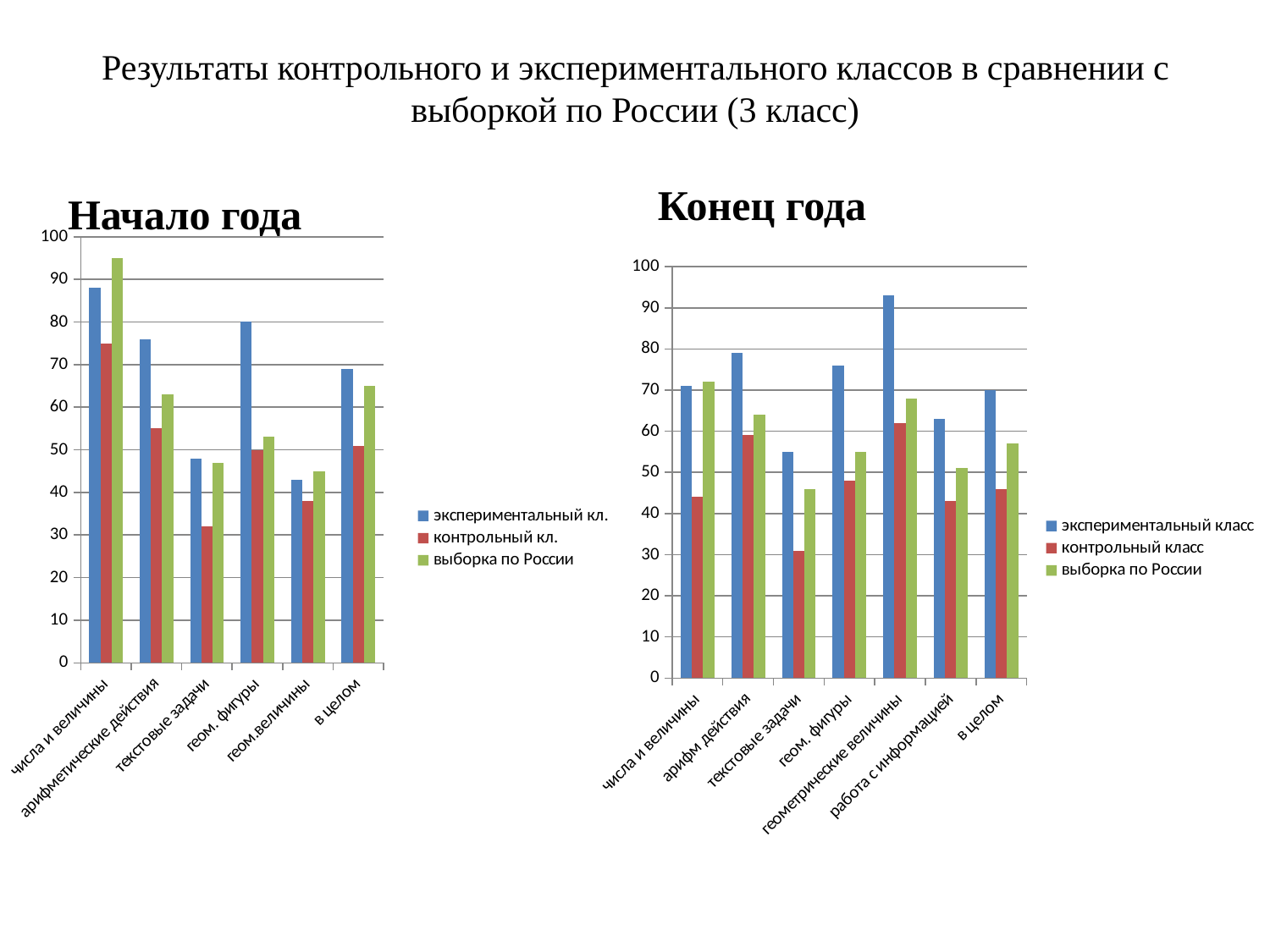
In the chart titled "Начало года", is the value of "выборка по России" for "числа и величины" greater or less than 90? greater What type of chart is the "Конец года" chart? bar chart In the chart titled "Конец года", for "в целом", which is larger: "экспериментальный класс" or "выборка по России"? экспериментальный класс In the chart titled "Начало года", which category has the highest value for the series "экспериментальный кл."? числа и величины In the chart titled "Конец года", how many categories are shown on the x axis? 7 In the chart titled "Конец года", which category has the lowest value for the series "контрольный класс"? текстовые задачи In the chart titled "Начало года", which legend entry is shown in green? выборка по России In the chart titled "Начало года", how many series does the legend list? 3 In the chart titled "Конец года", which category has the highest value for the series "экспериментальный класс"? геометрические величины In the chart titled "Конец года", is the value of "экспериментальный класс" for "геометрические величины" greater or less than 90? greater In the chart titled "Начало года", is the value of "контрольный кл." for "текстовые задачи" greater or less than 40? less In the chart titled "Начало года", how many categories are shown on the x axis? 6